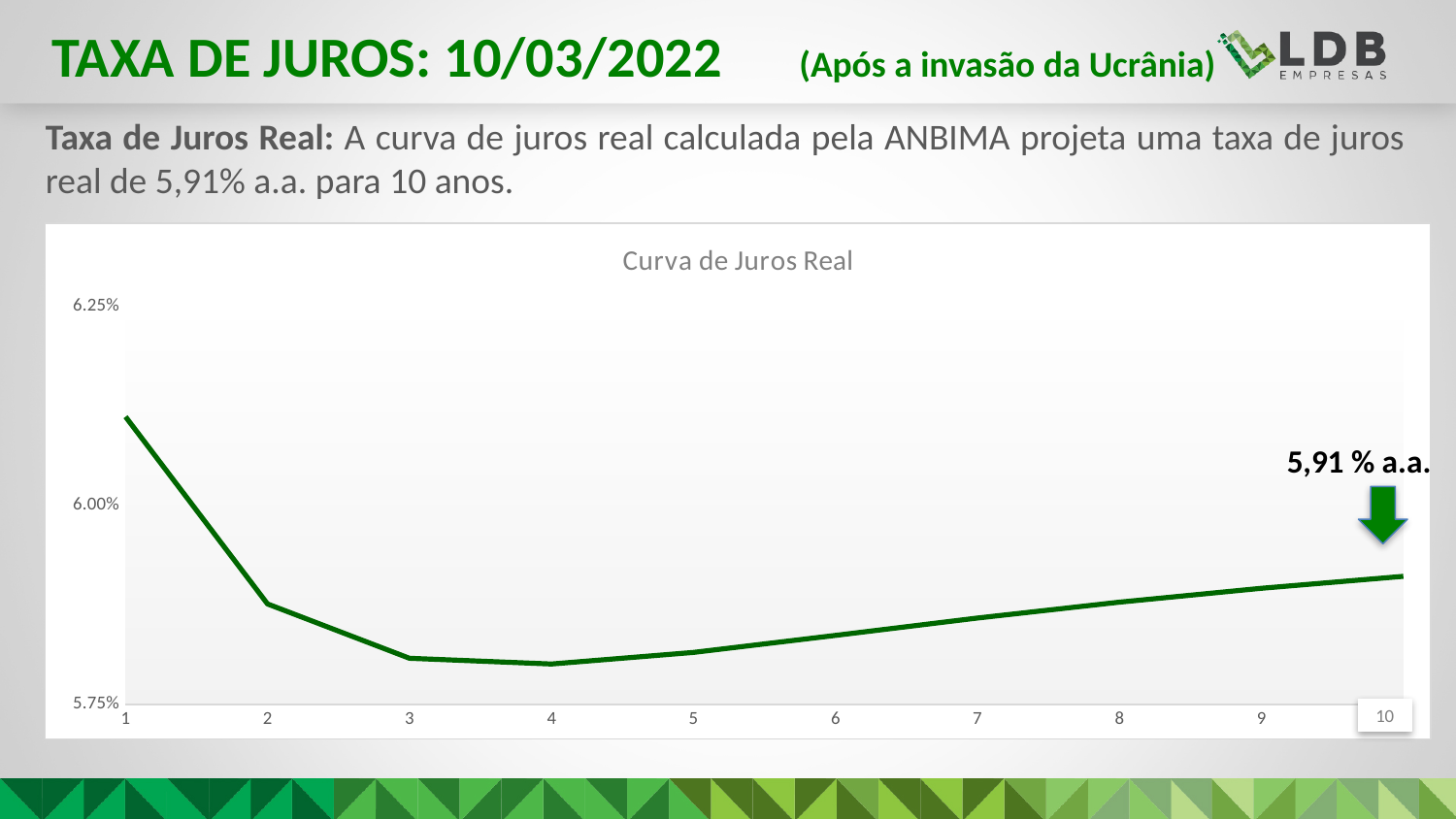
Is the value at point 7 greater or less than 6.00%? less Is the value at point 4 greater or less than 6.00%? less Which x-axis point has the highest value on the curve? 1 Which is larger, the value at point 1 or the value at point 10? point 1 What is the title of the chart? Curva de Juros Real What value is annotated for year 10 on the chart? 5,91 % a.a. Which is larger, the value at point 2 or the value at point 5? point 2 What kind of chart is shown on the slide? line chart How many points are plotted along the x axis of the chart? 10 Is the value at point 1 greater or less than 6.00%? greater Does the curve rise or fall between point 4 and point 10? rise Does the curve rise or fall between point 1 and point 4? fall